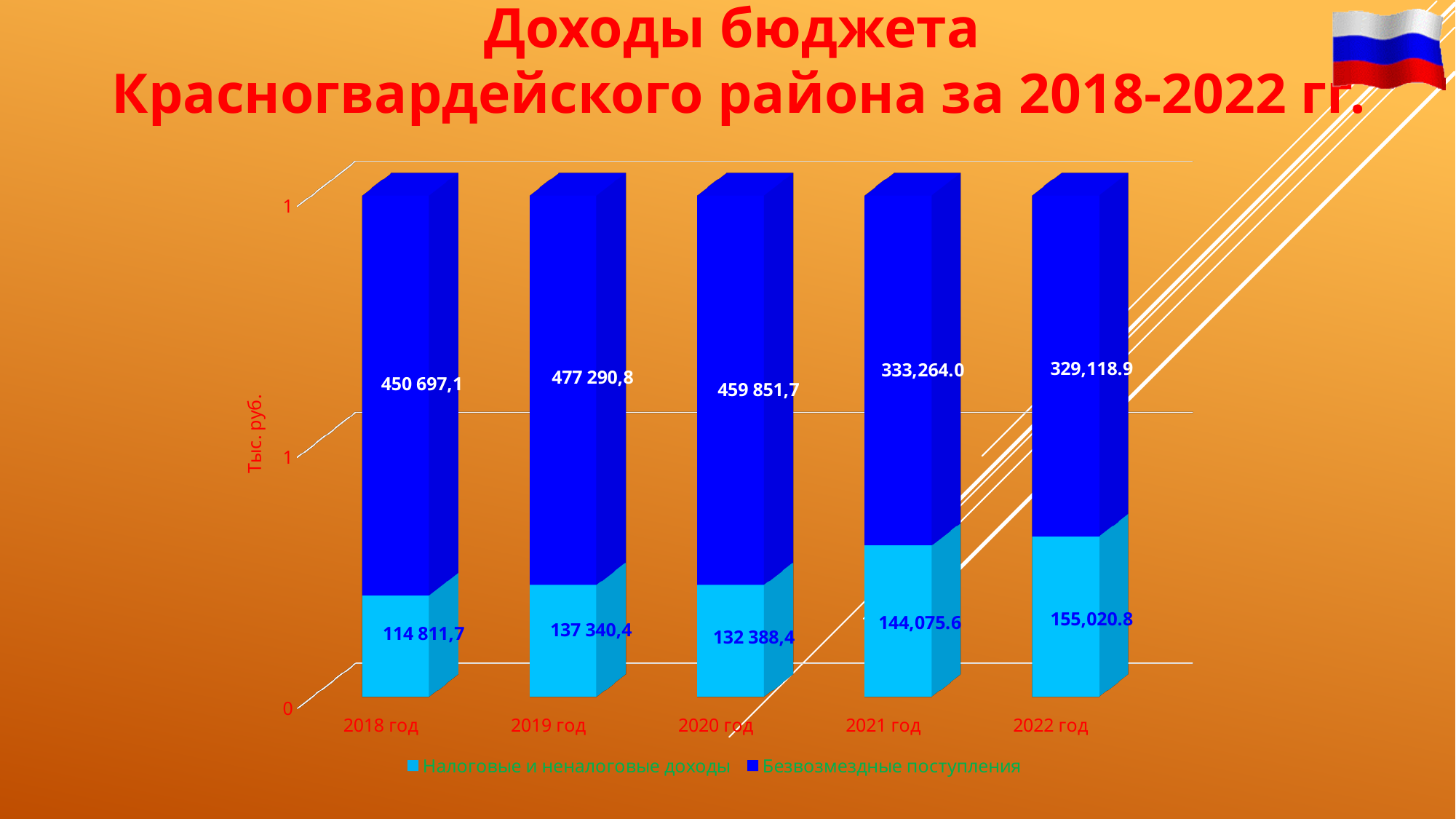
What is the total of the stacked bar for 2022 год? 484,139.7 In which year is the value for Безвозмездные поступления highest? 2019 год In which year is the value for Налоговые и неналоговые доходы lowest? 2018 год What kind of chart is shown on the slide? Stacked bar chart What is the value for Безвозмездные поступления in 2018 год? 450 697,1 What is the difference between the Налоговые и неналоговые доходы values for 2022 год and 2021 год? 10,945.2 What is the value for Налоговые и неналоговые доходы in 2022 год? 155,020.8 Which is larger: Безвозмездные поступления in 2020 год or in 2021 год? 2020 год What is the value for Налоговые и неналоговые доходы in 2020 год? 132 388,4 How many series does the legend list? 2 What is the label on the vertical axis? Тыс. руб. How many years are shown on the x axis? 5